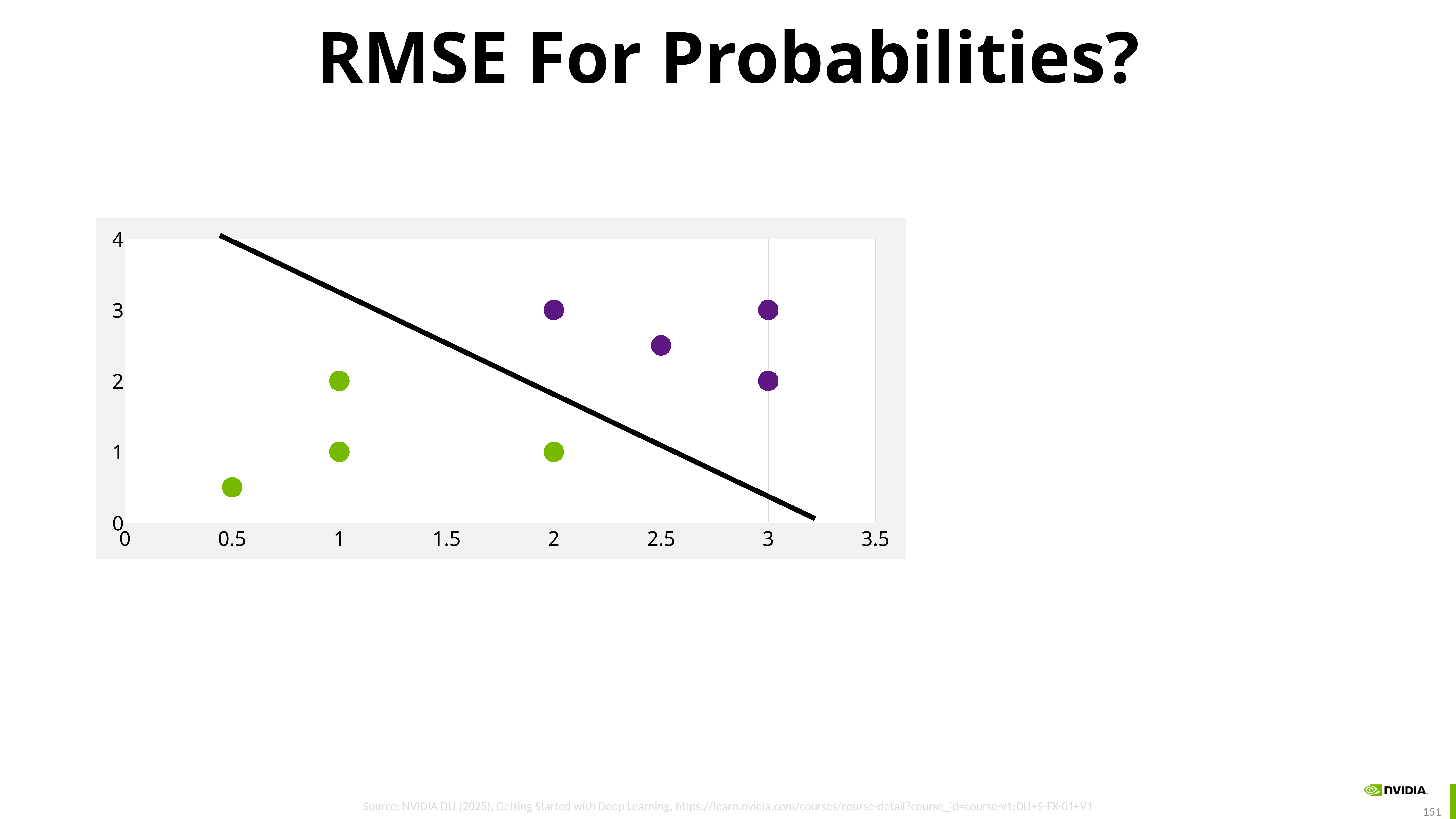
How many purple points are plotted at x = 3? 2 How many points in total are plotted on the chart? 8 At x = 2, which point is higher: the purple point or the green point? purple What two colours are used for the plotted points? green and purple Does the black line rise or fall as x increases? falls How many purple points are plotted on the chart? 4 Is the y value of the green point at x = 0.5 greater or less than 1? less What is the highest y value reached by any green point? 2 What kind of chart is shown on the slide? scatter chart What is the y value of the green point at x = 2? 1 What is the x value of the purple point at y = 2.5? 2.5